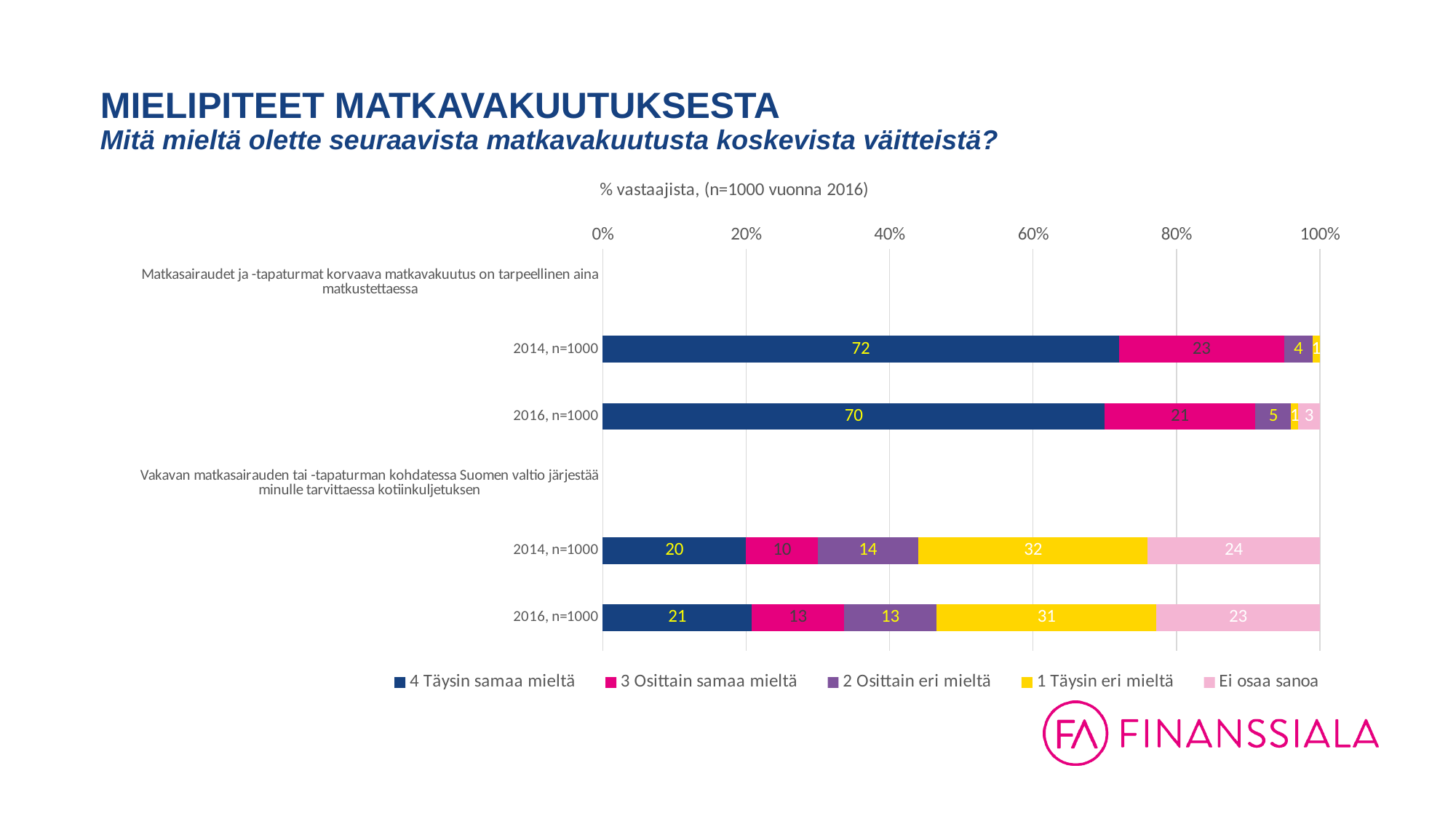
For the statement 'Vakavan matkasairauden tai -tapaturman kohdatessa Suomen valtio järjestää minulle tarvittaessa kotiinkuljetuksen', is the '3 Osittain samaa mieltä' share larger in 2014 or in 2016? 2016 How many series does the legend list? 5 How many bars are plotted on the chart? 4 Which response category has the smallest share in the 2016 bar for the statement 'Matkasairaudet ja -tapaturmat korvaava matkavakuutus on tarpeellinen aina matkustettaessa'? 1 Täysin eri mieltä By how much did the '4 Täysin samaa mieltä' share for the statement 'Matkasairaudet ja -tapaturmat korvaava matkavakuutus on tarpeellinen aina matkustettaessa' change from 2014 to 2016? 2 What kind of chart is shown on the slide? stacked bar chart What is the value for 'Ei osaa sanoa' in the 2016 bar for the statement 'Vakavan matkasairauden tai -tapaturman kohdatessa Suomen valtio järjestää minulle tarvittaessa kotiinkuljetuksen'? 23 Which response category has the largest share in the 2016 bar for the statement 'Vakavan matkasairauden tai -tapaturman kohdatessa Suomen valtio järjestää minulle tarvittaessa kotiinkuljetuksen'? 1 Täysin eri mieltä What is the value for '1 Täysin eri mieltä' in the 2014 bar for the statement 'Vakavan matkasairauden tai -tapaturman kohdatessa Suomen valtio järjestää minulle tarvittaessa kotiinkuljetuksen'? 32 What is the value for '4 Täysin samaa mieltä' in the 2014 bar for the statement 'Matkasairaudet ja -tapaturmat korvaava matkavakuutus on tarpeellinen aina matkustettaessa'? 72 What is the total of the 2014 bar for the statement 'Vakavan matkasairauden tai -tapaturman kohdatessa Suomen valtio järjestää minulle tarvittaessa kotiinkuljetuksen'? 100 What is the value for '3 Osittain samaa mieltä' in the 2016 bar for the statement 'Matkasairaudet ja -tapaturmat korvaava matkavakuutus on tarpeellinen aina matkustettaessa'? 21